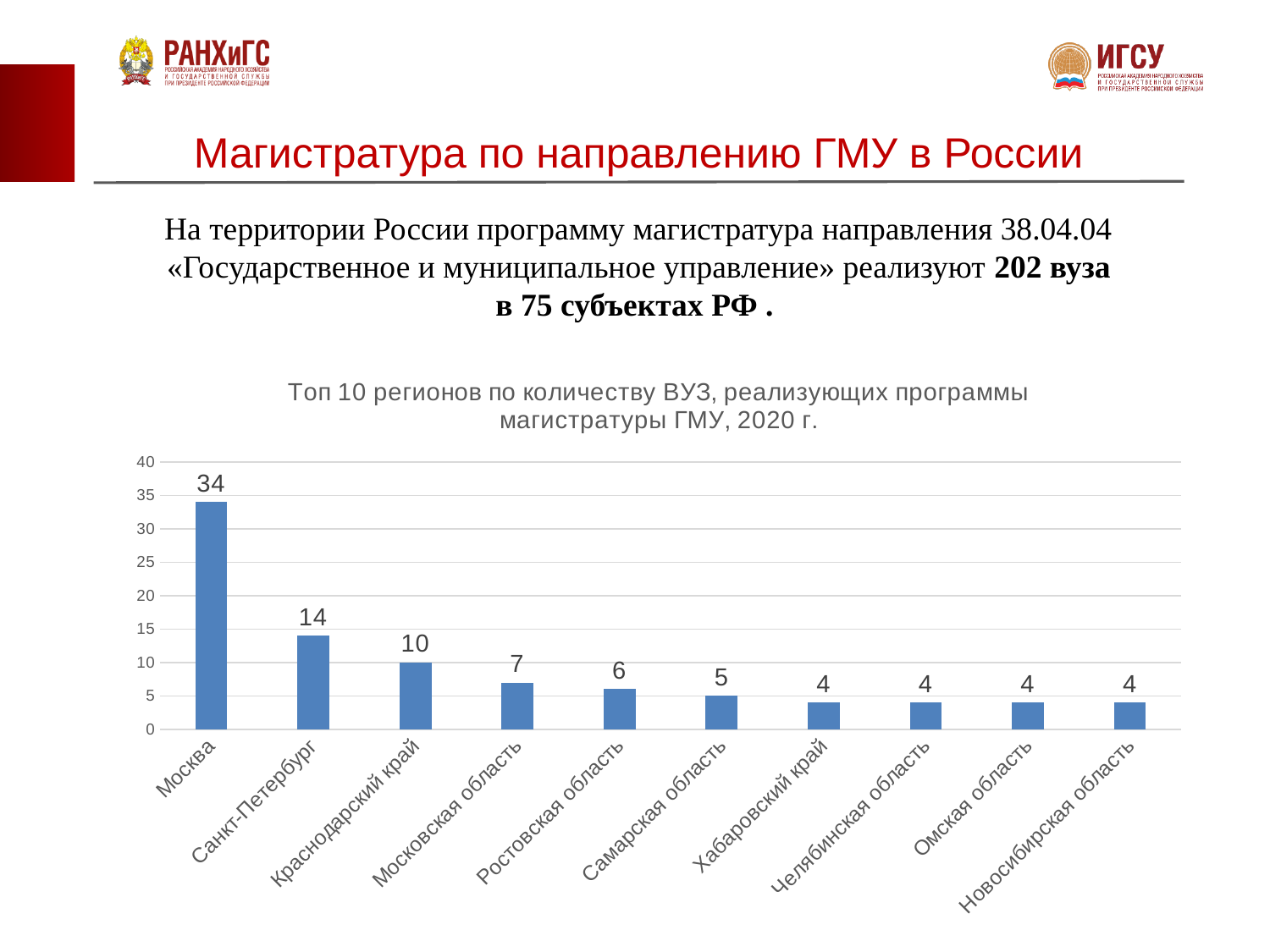
Do the values rise or fall from left to right along the x axis? fall Which region has the highest value? Москва What is the title of the chart? Топ 10 регионов по количеству ВУЗ, реализующих программы магистратуры ГМУ, 2020 г. Is the value for Краснодарский край greater or less than 15? less What is the difference between the values for Краснодарский край and Московская область? 3 What is the value for Санкт-Петербург? 14 How many regions are shown in the chart? 10 Which is larger, the value for Самарская область or the value for Хабаровский край? Самарская область What is the difference between the values for Москва and Санкт-Петербург? 20 What is the value for Ростовская область? 6 What kind of chart is shown on the slide? bar chart What is the value for Москва? 34